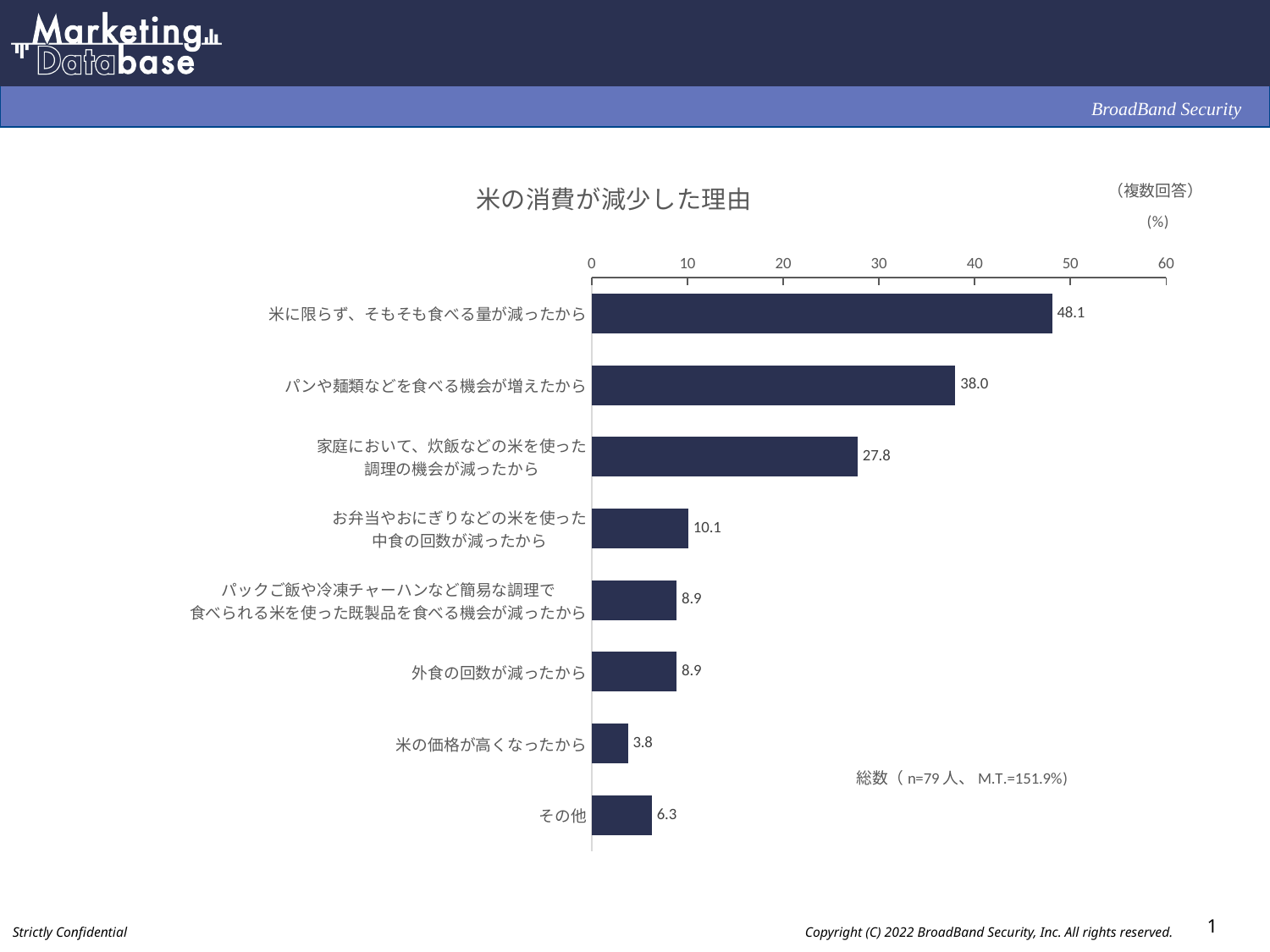
What kind of chart is shown on the slide? bar chart What is the value for 外食の回数が減ったから? 8.9 What is the value for 米に限らず、そもそも食べる量が減ったから? 48.1 Which category has the highest value? 米に限らず、そもそも食べる量が減ったから What is the title of the chart? 米の消費が減少した理由 Which is larger, the value for 家庭において、炊飯などの米を使った調理の機会が減ったから or the value for お弁当やおにぎりなどの米を使った中食の回数が減ったから? 家庭において、炊飯などの米を使った調理の機会が減ったから How many categories are shown in the chart? 8 Is the value for 家庭において、炊飯などの米を使った調理の機会が減ったから greater or less than 30? less What is the value for パンや麺類などを食べる機会が増えたから? 38.0 What is the value for その他? 6.3 What is the difference between the values for 米に限らず、そもそも食べる量が減ったから and パンや麺類などを食べる機会が増えたから? 10.1 Which category has the lowest value? 米の価格が高くなったから